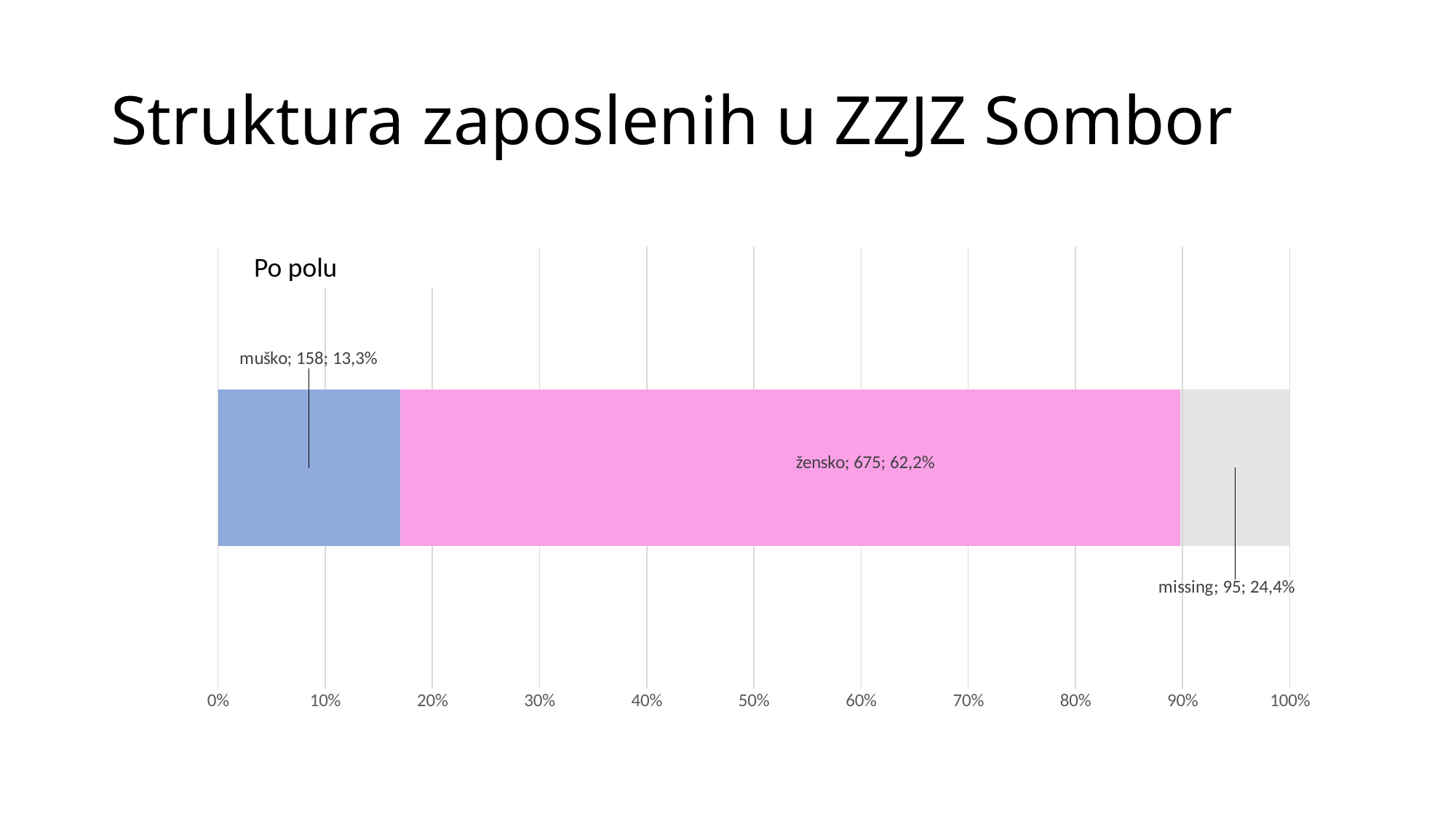
What is the count shown for the 'missing' segment? 95 What percentage is printed for the 'žensko' segment? 62,2% What is the difference between the counts for 'žensko' and 'muško'? 517 Which segment has the highest count? žensko What is the title of the chart on the slide? Po polu What is the total count across all three segments of the bar? 928 Which segment has the lowest count? missing What is the count shown for the 'žensko' segment? 675 How many segments (categories) does the bar contain? 3 What percentage is printed for the 'muško' segment? 13,3% What is the count shown for the 'muško' segment? 158 What kind of chart is shown on the slide? bar chart